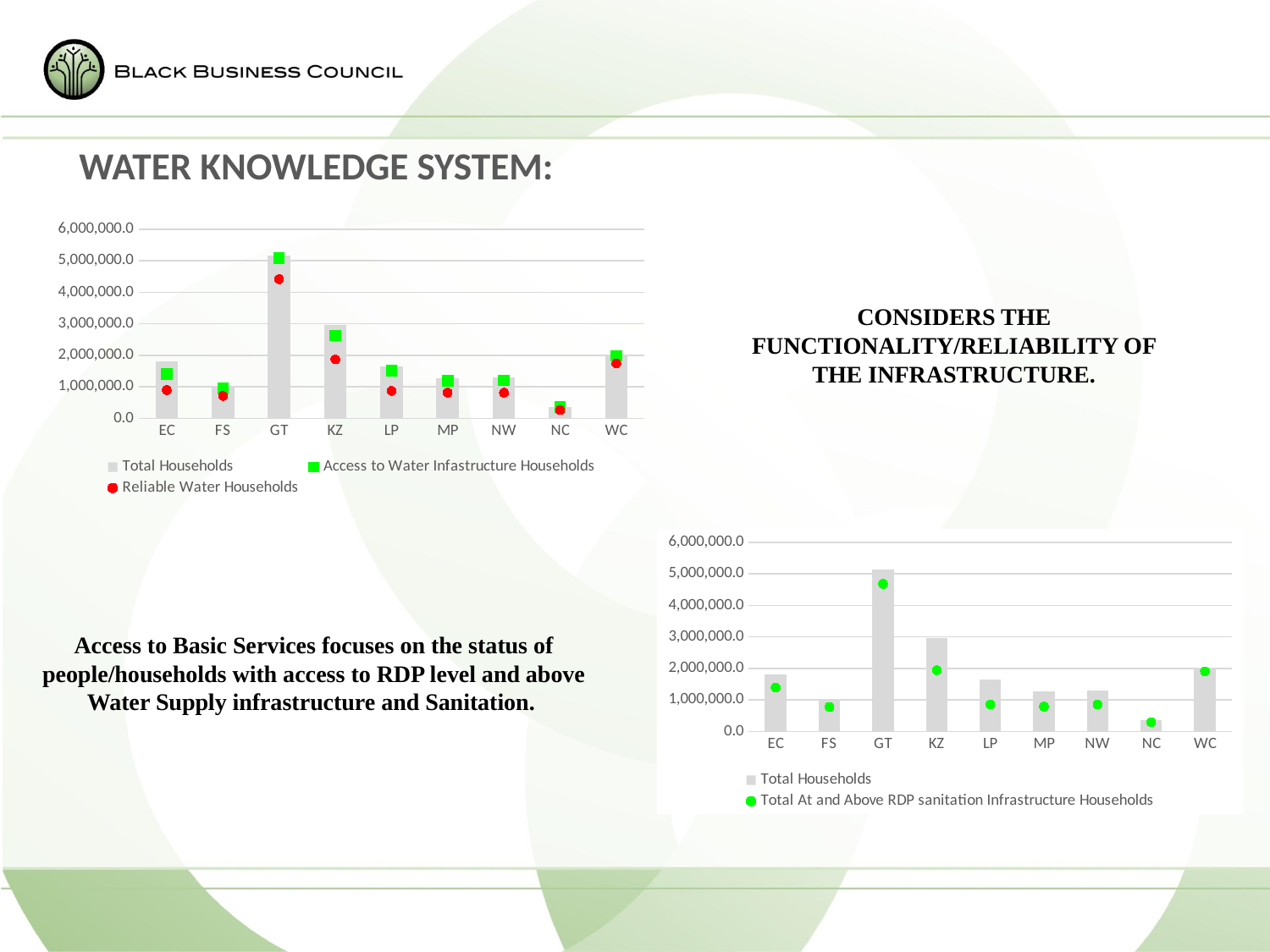
In the bottom-right chart, is the Total Households value for KZ greater or less than 2,000,000.0? greater In the bottom-right chart, which has the larger Total Households value, WC or NC? WC What kind of chart is the bottom-right chart's Total Households series drawn as? Bar chart In the top-left chart, how many categories are shown on the x axis? 9 In the top-left chart, which has the larger Total Households value, EC or FS? EC In the bottom-right chart, which category has the lowest Total Households value? NC In the top-left chart, how many series does the legend list? 3 In the top-left chart, is the Total Households value for GT greater or less than 4,000,000.0? greater In the top-left chart, what colour are the markers for the Reliable Water Households series? Red In the top-left chart, which category has the highest Total Households value? GT In the bottom-right chart, how many series does the legend list? 2 In the bottom-right chart, is the Total Households value for NC greater or less than 1,000,000.0? less